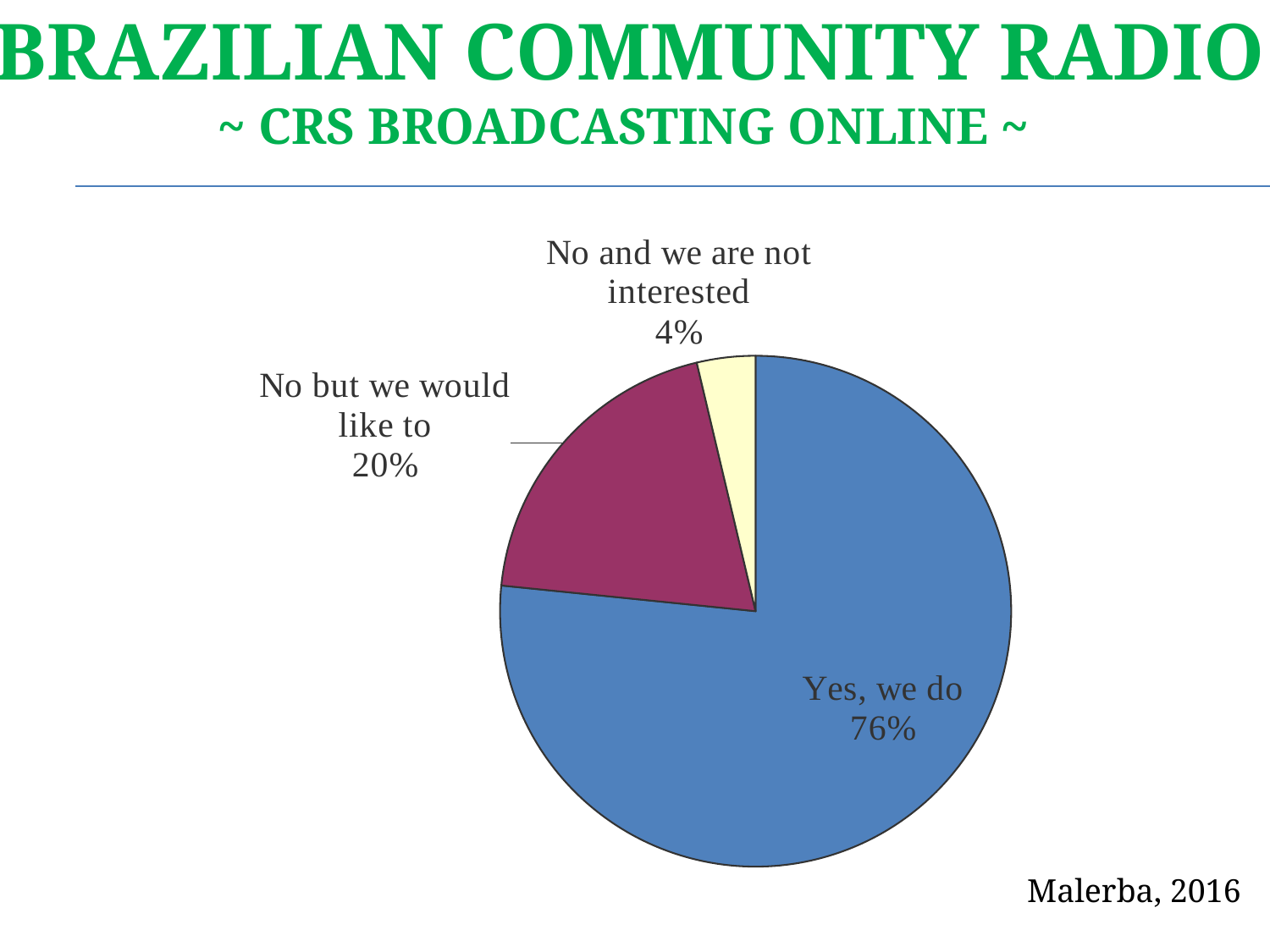
What is the difference in percentage points between "No but we would like to" and "No and we are not interested"? 16 How many slices does the pie chart have? 3 What share of the pie is labelled "Yes, we do"? 76% What is the difference in percentage points between "Yes, we do" and "No but we would like to"? 56 Which is larger: the share for "No but we would like to" or the share for "No and we are not interested"? No but we would like to What share of the pie is labelled "No and we are not interested"? 4% What share of the pie is labelled "No but we would like to"? 20% Which category has the largest slice of the pie? Yes, we do What source is cited below the chart? Malerba, 2016 Which category has the smallest slice of the pie? No and we are not interested What kind of chart is shown on the slide? pie chart What colour is the "Yes, we do" slice? blue